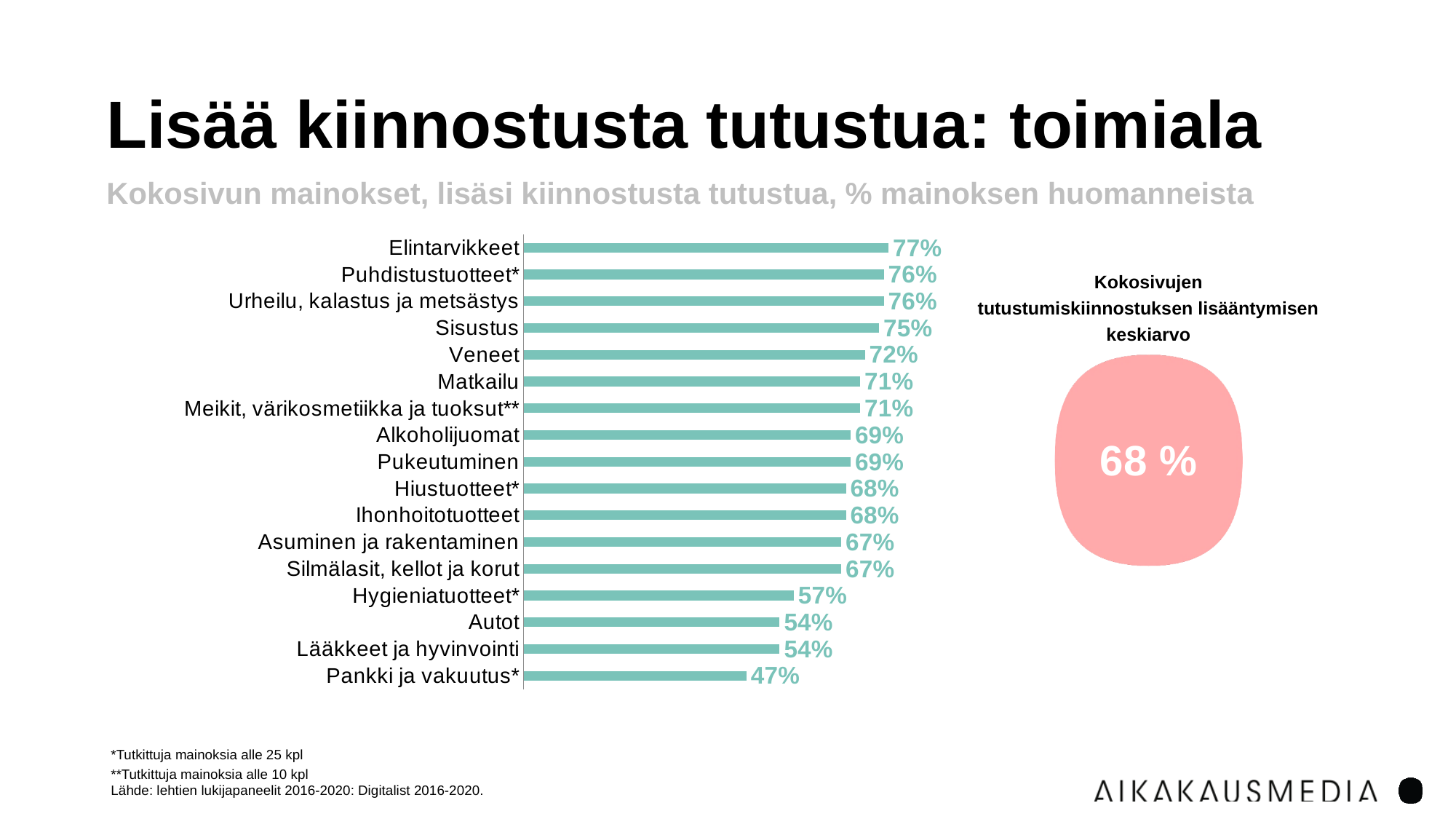
What is the value for Pankki ja vakuutus*? 47% What is the value for Elintarvikkeet? 77% Which category has the lowest value? Pankki ja vakuutus* What kind of chart is shown on the slide? Bar chart How many categories are shown in the bar chart? 17 Which category has the highest value? Elintarvikkeet Which is larger, the value for Matkailu or the value for Hygieniatuotteet*? Matkailu What is the difference between the values for Elintarvikkeet and Pankki ja vakuutus*? 30 percentage points What average value is shown in the pink circle on the right of the slide? 68 % What is the value for Veneet? 72% What is the value for Hygieniatuotteet*? 57% What is the difference between the values for Sisustus and Autot? 21 percentage points